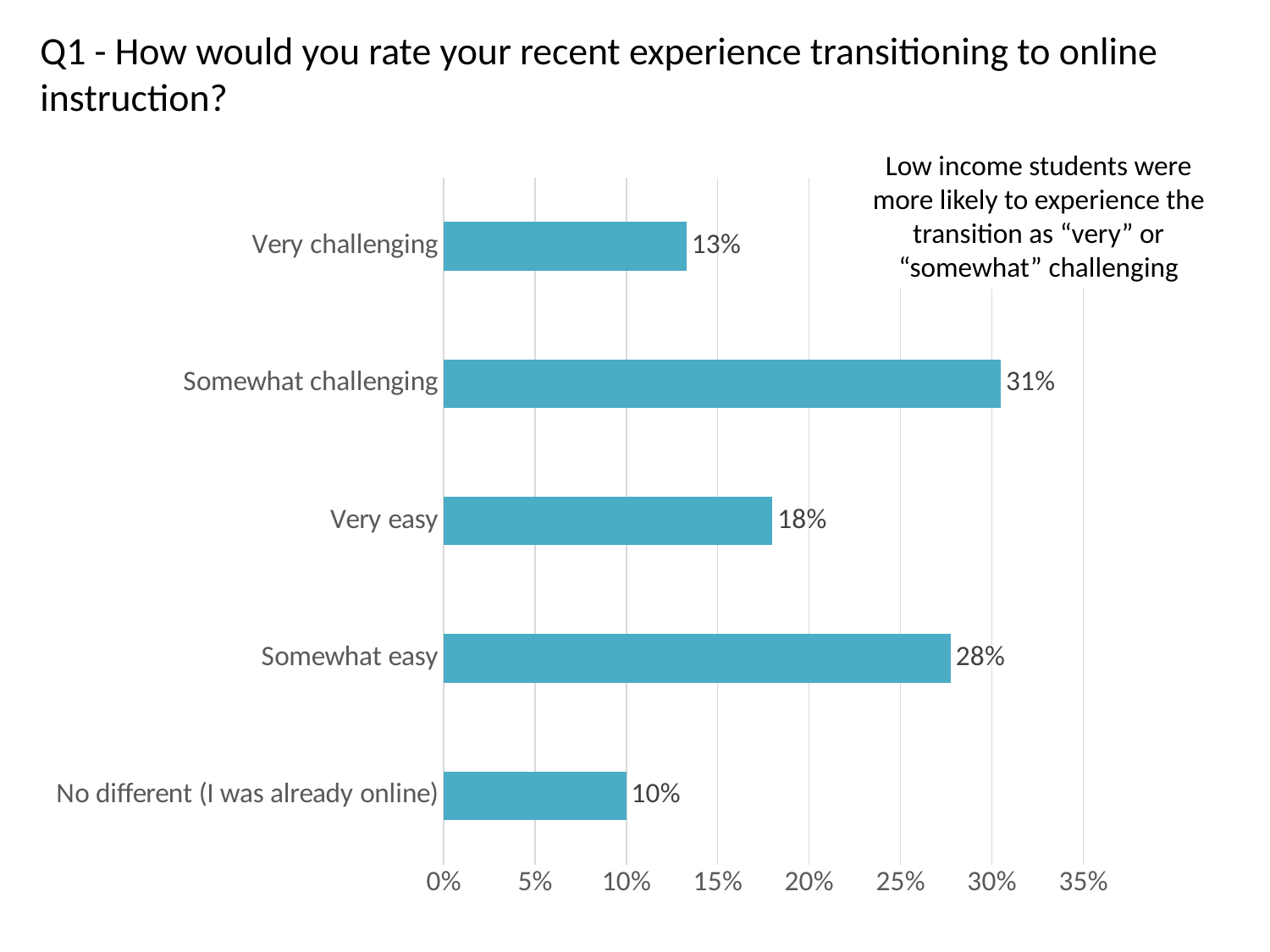
What is the difference between the values for "Very easy" and "Very challenging"? 5% How many categories are shown in the chart? 5 What percentage of respondents rated the transition as "Very challenging"? 13% Which is larger, the value for "Very easy" or the value for "Very challenging"? Very easy What percentage of respondents said the transition was "No different (I was already online)"? 10% Which category has the lowest value? No different (I was already online) Which category has the highest value? Somewhat challenging What value is shown for "Somewhat easy"? 28% Is the value for "Somewhat challenging" greater or less than 30%? greater What kind of chart is shown on the slide? Bar chart What is the difference between the values for "Somewhat challenging" and "Somewhat easy"? 3% What is the maximum value shown on the horizontal axis? 35%